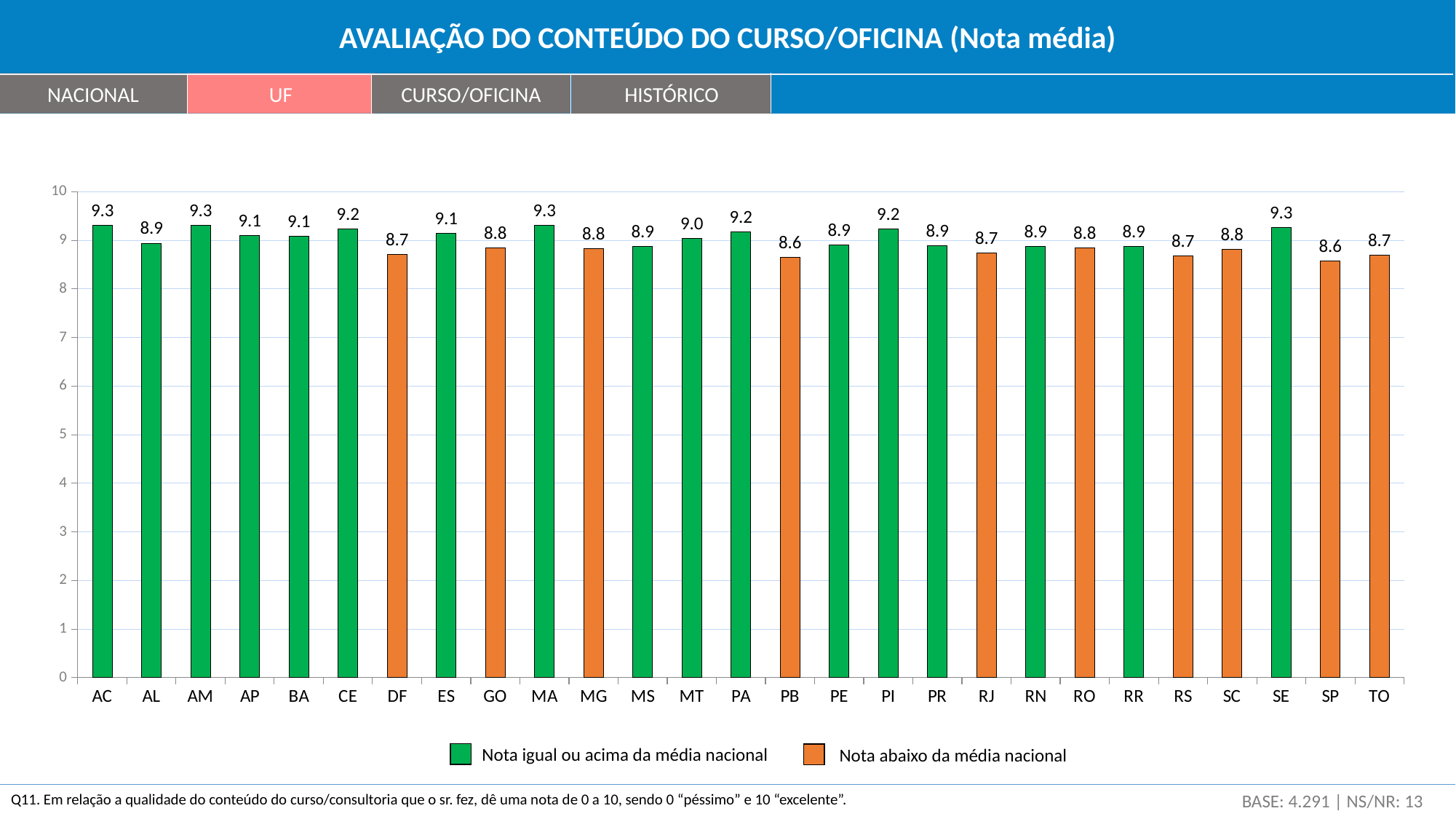
What is the difference between the values for MT and SP? 0.4 What is the value for AC? 9.3 What is the value for DF? 8.7 What does the orange colour in the legend represent? Nota abaixo da média nacional What is the difference between the values for AC and DF? 0.6 How many UF categories are shown on the x axis? 27 What kind of chart is shown on the slide? bar chart Is the value for PB greater or less than 8? greater What is the value for SP? 8.6 How many series does the legend list? 2 What is the value for MT? 9.0 Which has a larger value, CE or RJ? CE